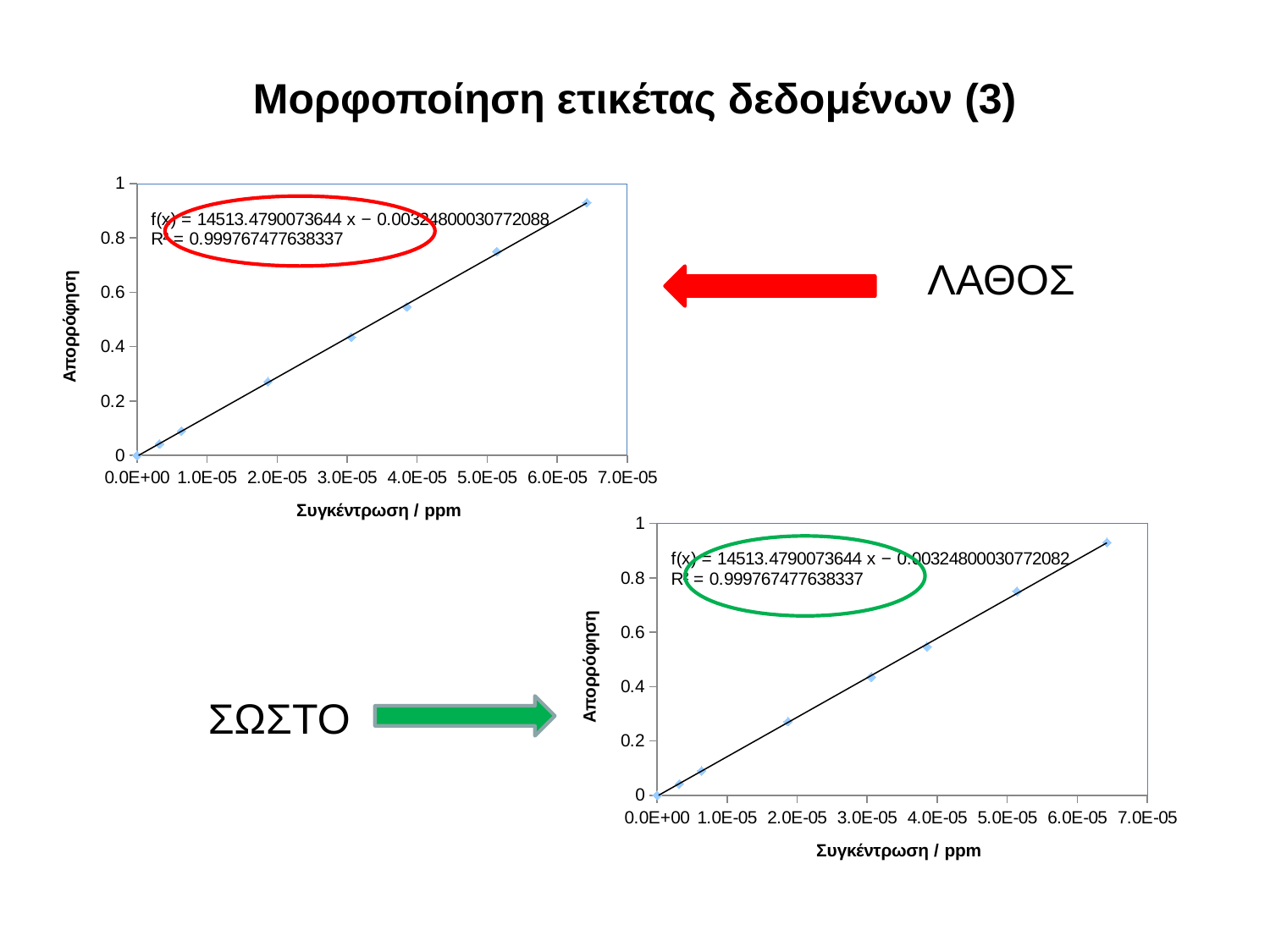
In the bottom chart, does the highest absorbance occur at the lowest or the highest concentration? the highest concentration How many data points are plotted in the top chart? 8 What kind of chart is the top chart on the slide? scatter chart In the top chart, is the absorbance of the point near 2.0E-05 ppm greater or less than 0.4? less In the top chart, is the absorbance of the point at the highest concentration greater or less than 0.8? greater In the top chart, do the absorbance values rise or fall as concentration increases along the x axis? rise In the top chart, which point has the larger absorbance: the one near 3.0E-05 ppm or the one near 5.0E-05 ppm? the one near 5.0E-05 ppm What is the slope of the trendline equation printed on the bottom chart? 14513.4790073644 In the bottom chart, is the absorbance of the point near 5.0E-05 ppm greater or less than 0.6? greater What is the x-axis title of the bottom chart? Συγκέντρωση / ppm What R² value is printed on the top chart? 0.999767477638337 What is the y-axis title of the top chart? Απορρόφηση